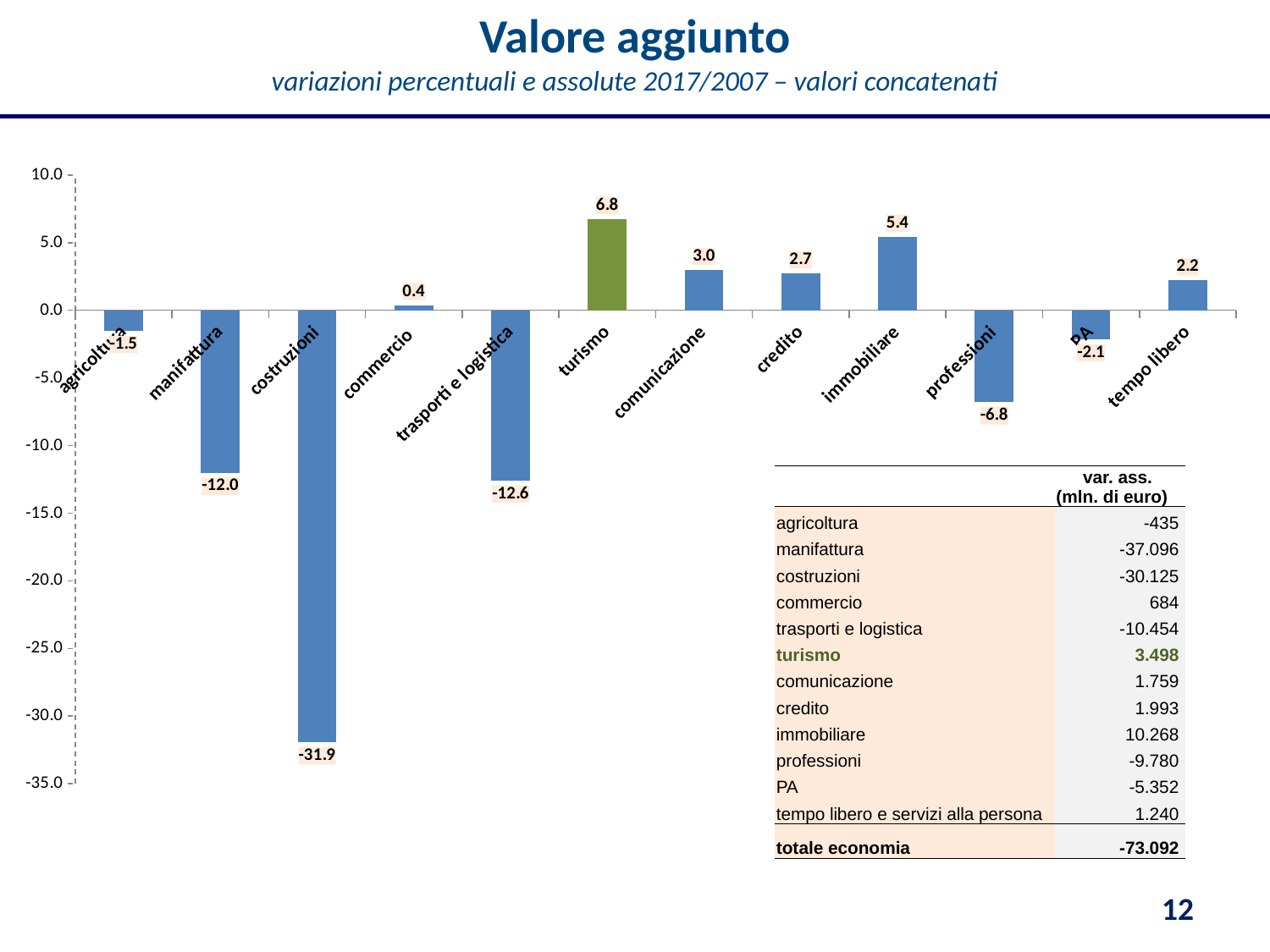
Which has a larger value in the bar chart, comunicazione or credito? comunicazione What is the value shown for costruzioni in the bar chart? -31.9 What is the value shown for immobiliare in the bar chart? 5.4 Is the value for manifattura in the bar chart greater or less than -10.0? less What is the difference between the values for turismo and immobiliare in the bar chart? 1.4 Which category has the highest value in the bar chart? turismo Which category has the lowest value in the bar chart? costruzioni How many categories are shown in the bar chart? 12 Which bar in the chart is coloured green rather than blue? turismo What is the value shown for trasporti e logistica in the bar chart? -12.6 What kind of chart is shown on the slide? bar chart What is the value shown for turismo in the bar chart? 6.8